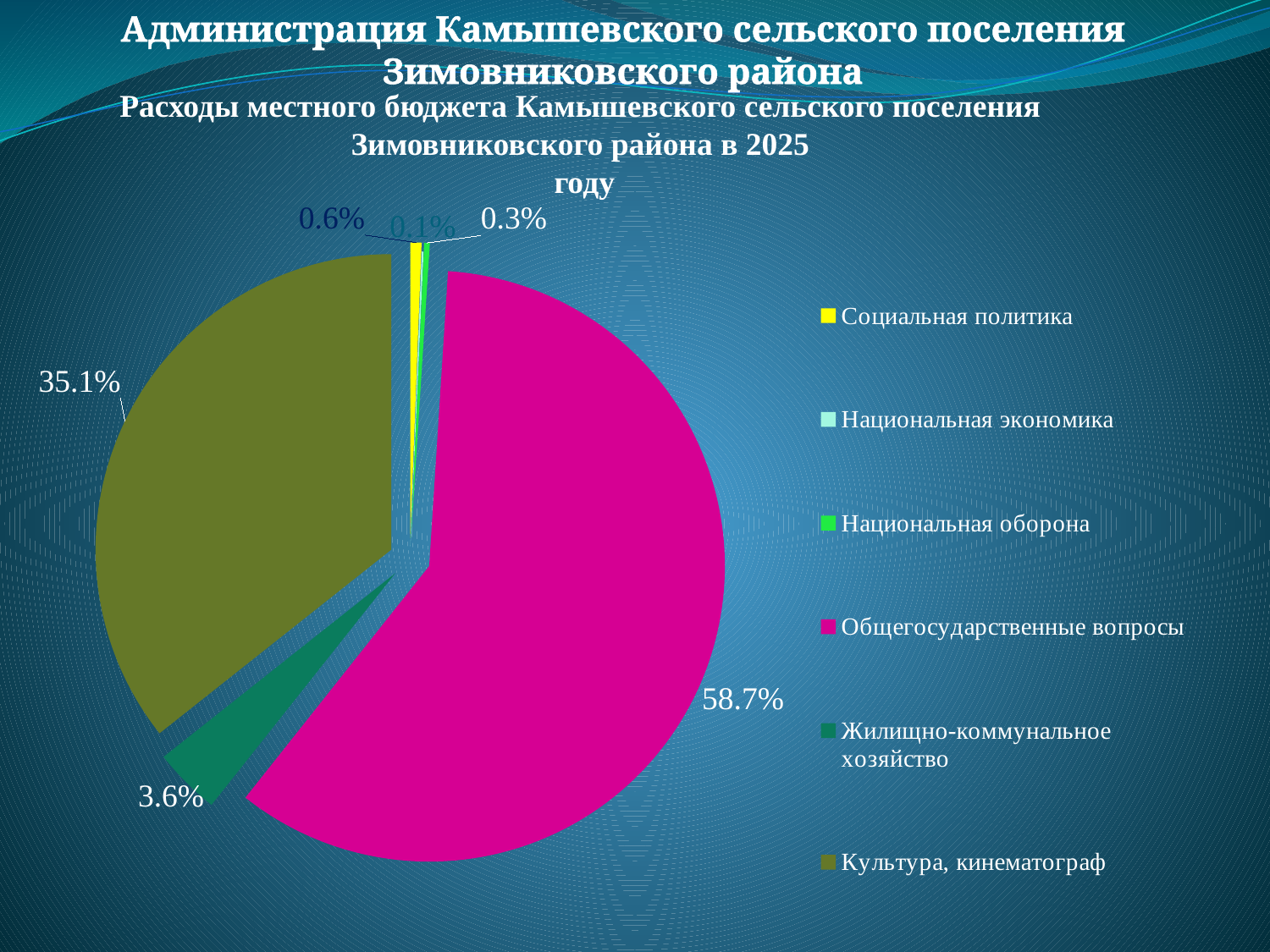
What colour is the slice for Общегосударственные вопросы? magenta What share of the pie does Общегосударственные вопросы have? 58.7% Which category has the smallest slice of the pie? Национальная экономика What share of the pie does Культура, кинематограф have? 35.1% What share of the pie does Жилищно-коммунальное хозяйство have? 3.6% Which is larger: the share of Жилищно-коммунальное хозяйство or the share of Социальная политика? Жилищно-коммунальное хозяйство What kind of chart is shown on the slide? pie chart Which category has the largest slice of the pie? Общегосударственные вопросы What is the difference between the shares of Общегосударственные вопросы and Культура, кинематограф? 23.6% How many categories does the legend of the pie chart list? 6